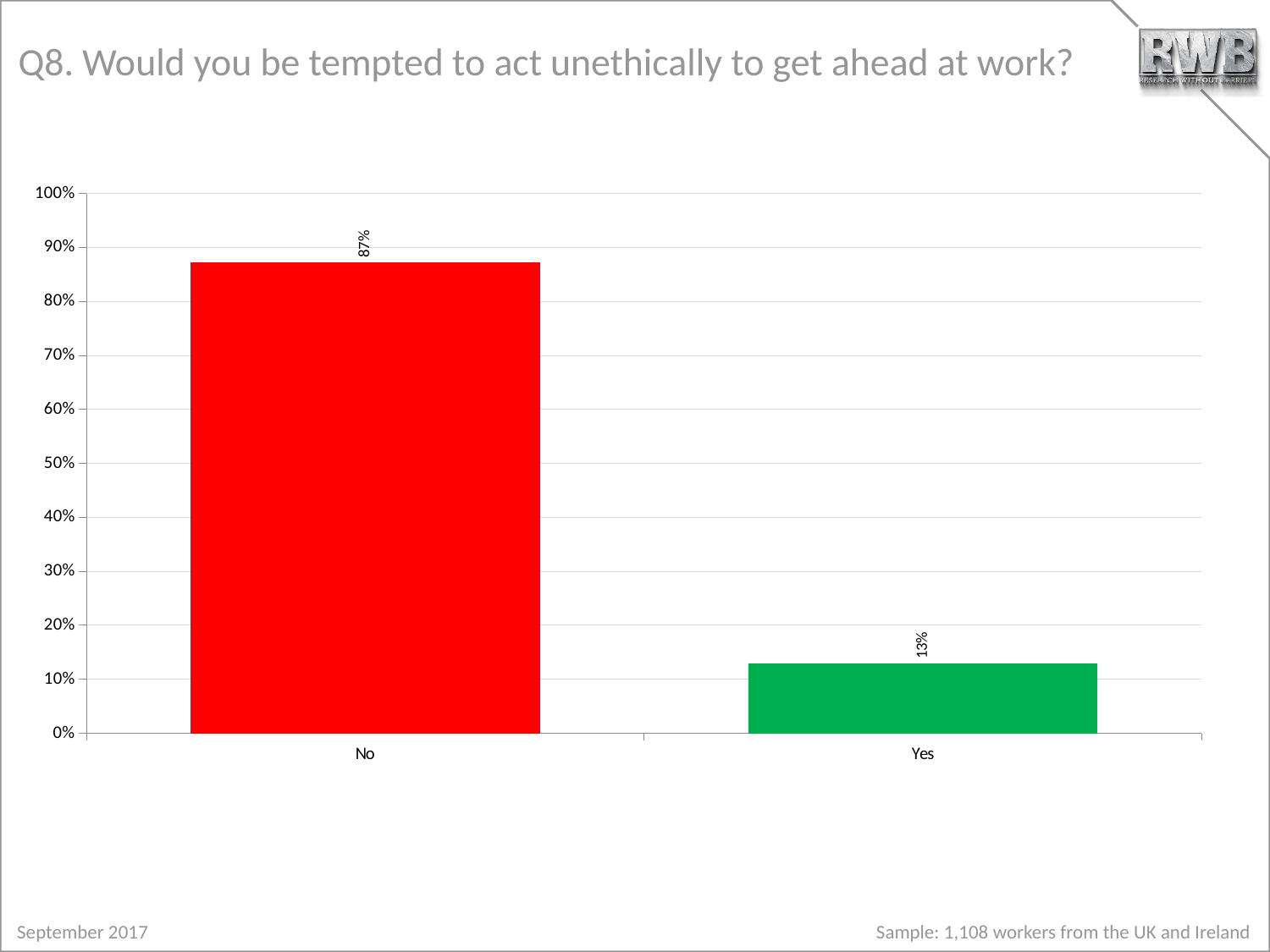
Which response has the highest value? No What is the maximum value shown on the vertical axis? 100% What is the difference in percentage points between the "No" and "Yes" responses? 74 percentage points Which response has the lowest value? Yes Is the value for "No" greater or less than 80%? greater What kind of chart is shown on the slide? Bar chart What colour is the bar for "No"? Red How many response categories are shown on the chart? 2 What percentage of respondents answered "Yes"? 13% Which is larger, the value for "No" or the value for "Yes"? No What percentage of respondents answered "No"? 87% Is the value for "Yes" greater or less than 20%? less